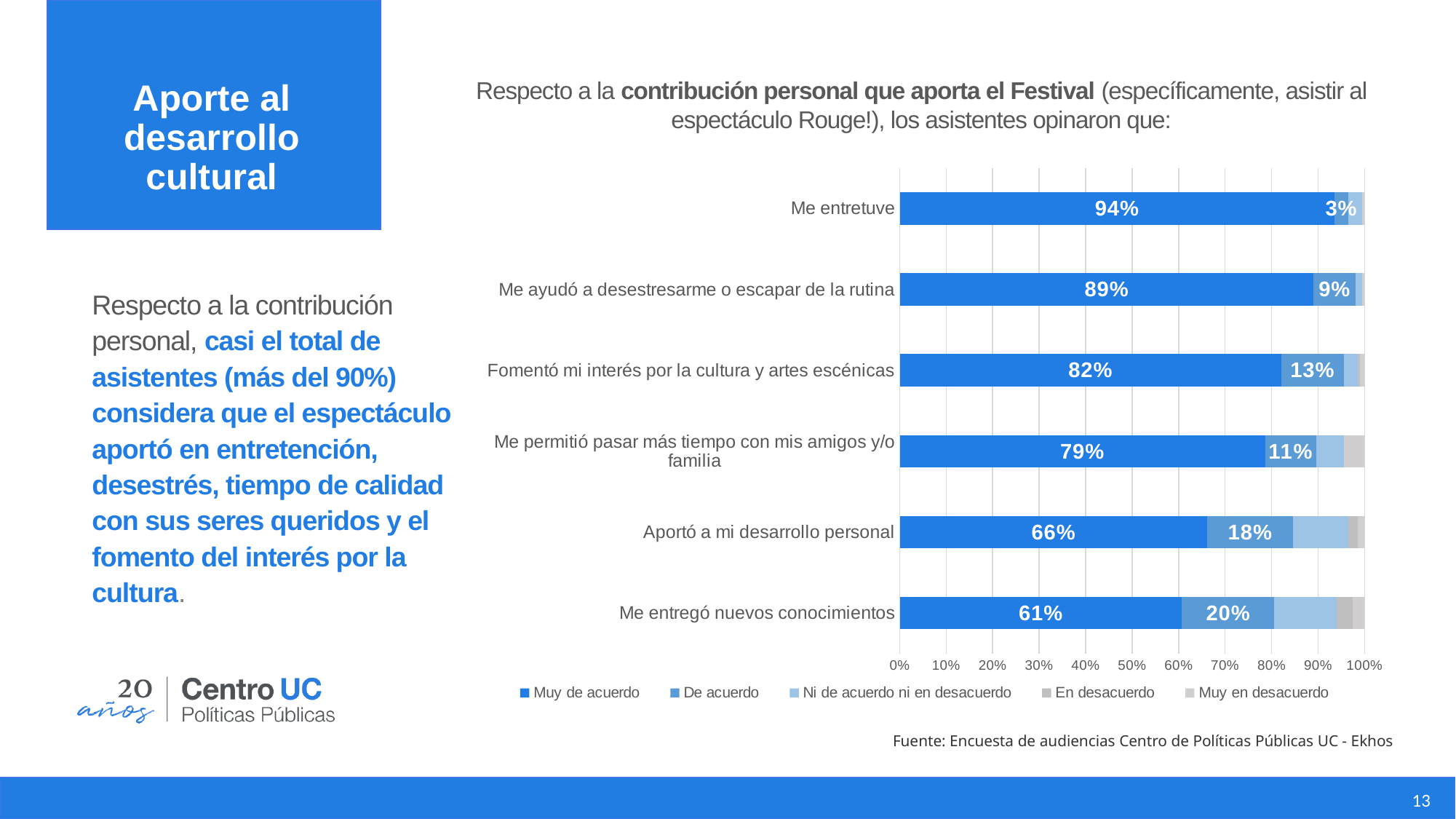
Is the 'Muy de acuerdo' value for 'Aportó a mi desarrollo personal' greater or less than 70%? less What is the 'Muy de acuerdo' value for 'Me entregó nuevos conocimientos'? 61% Which has a larger 'De acuerdo' value: 'Fomentó mi interés por la cultura y artes escénicas' or 'Me permitió pasar más tiempo con mis amigos y/o familia'? Fomentó mi interés por la cultura y artes escénicas Which legend entry is shown in the darkest blue colour? Muy de acuerdo What kind of chart is shown on the slide? Stacked bar chart What is the 'De acuerdo' value for 'Me ayudó a desestresarme o escapar de la rutina'? 9% Which statement has the highest 'Muy de acuerdo' value? Me entretuve How many series does the chart legend list? 5 Which statement has the lowest 'Muy de acuerdo' value? Me entregó nuevos conocimientos What is the 'Muy de acuerdo' value for 'Me entretuve'? 94% How many statements (categories) are plotted in the chart? 6 What is the difference between the 'Muy de acuerdo' values for 'Me entretuve' and 'Aportó a mi desarrollo personal'? 28%